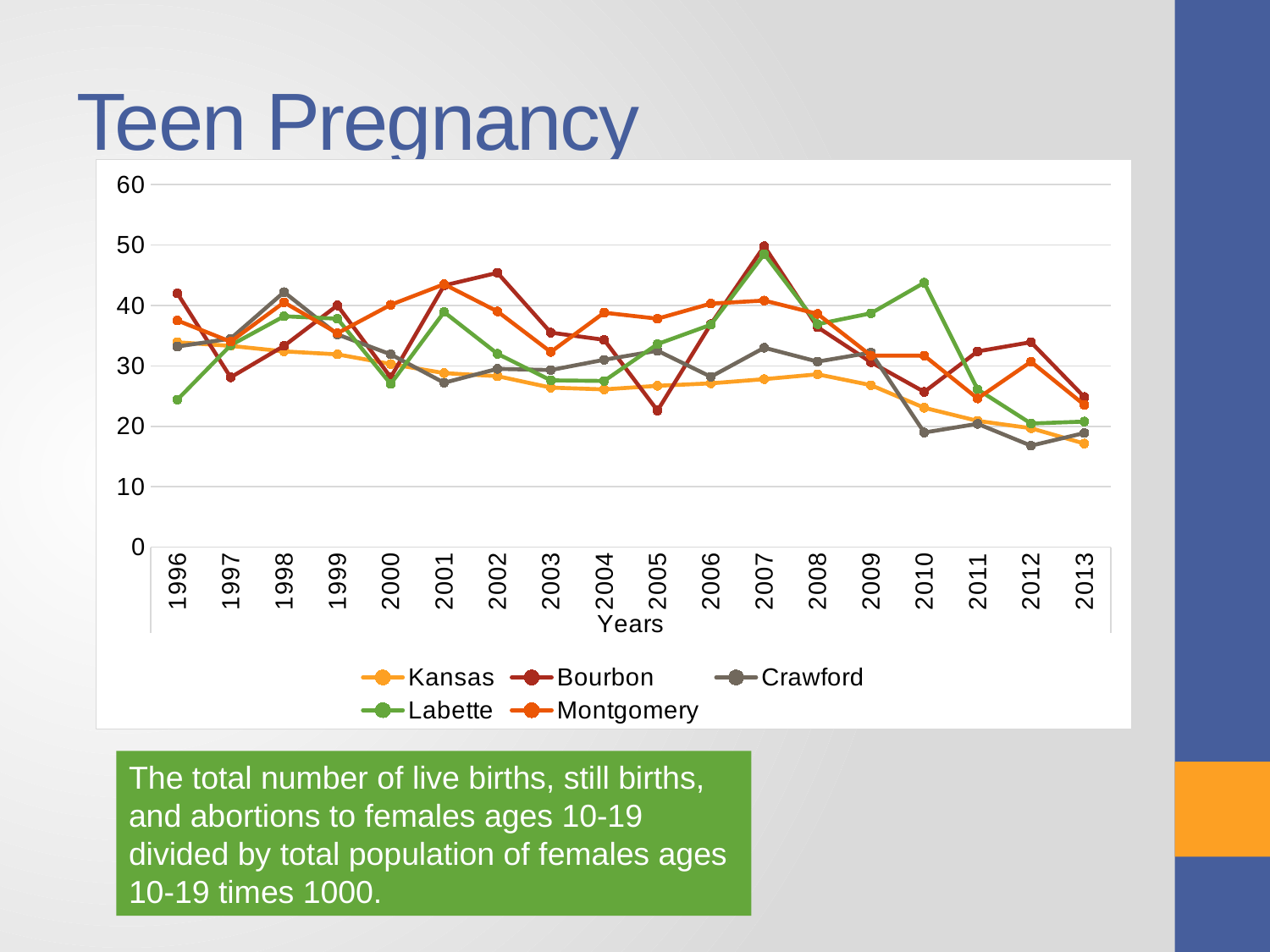
How many series does the legend list? 5 Is the value for Labette in 2010 greater or less than 40? greater How many years are plotted along the x axis? 18 In 2010, which is larger, the value for Labette or the value for Crawford? Labette What is the label on the x axis? Years Is the value for Kansas in 2013 greater or less than 20? less Does the Kansas series generally rise or fall from 1996 to 2013? fall What kind of chart is shown on the slide? line chart Is the value for Bourbon in 2002 greater or less than 40? greater Which series reaches the highest value on the chart, and in which year? Bourbon, 2007 In 2007, which is larger, the value for Bourbon or the value for Kansas? Bourbon